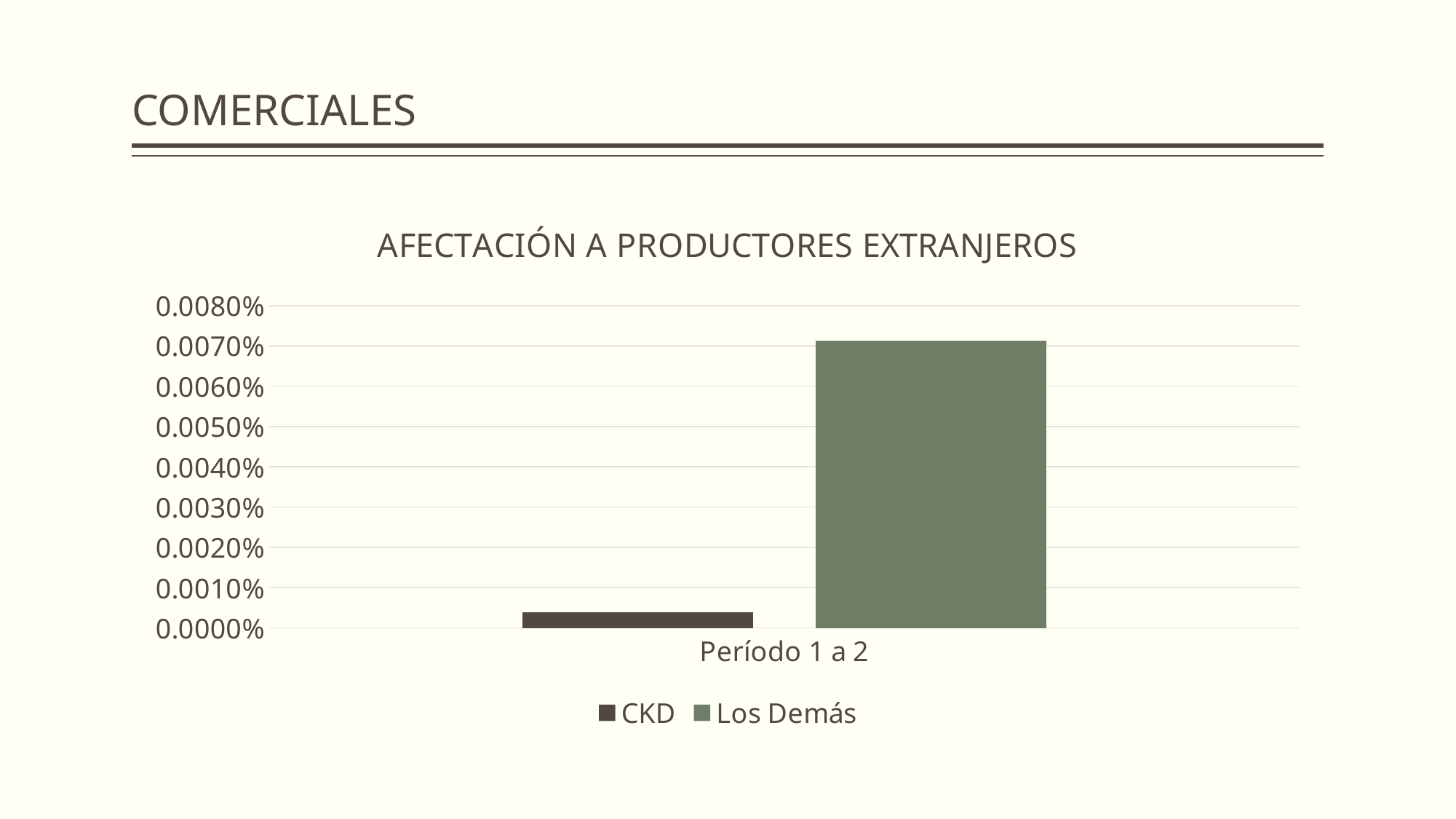
How many categories are shown on the x axis? 1 Is the value for Los Demás greater or less than 0.0080%? less Which series are listed in the legend? CKD and Los Demás What is the title of the chart? AFECTACIÓN A PRODUCTORES EXTRANJEROS Is the value for CKD greater or less than 0.0010%? less What type of chart is shown on the slide? bar chart Is the value for CKD greater or less than 0.0030%? less Which series has the highest value in the chart? Los Demás Which series has the higher value for Período 1 a 2, CKD or Los Demás? Los Demás How many series does the legend list? 2 Which series has the lowest value in the chart? CKD